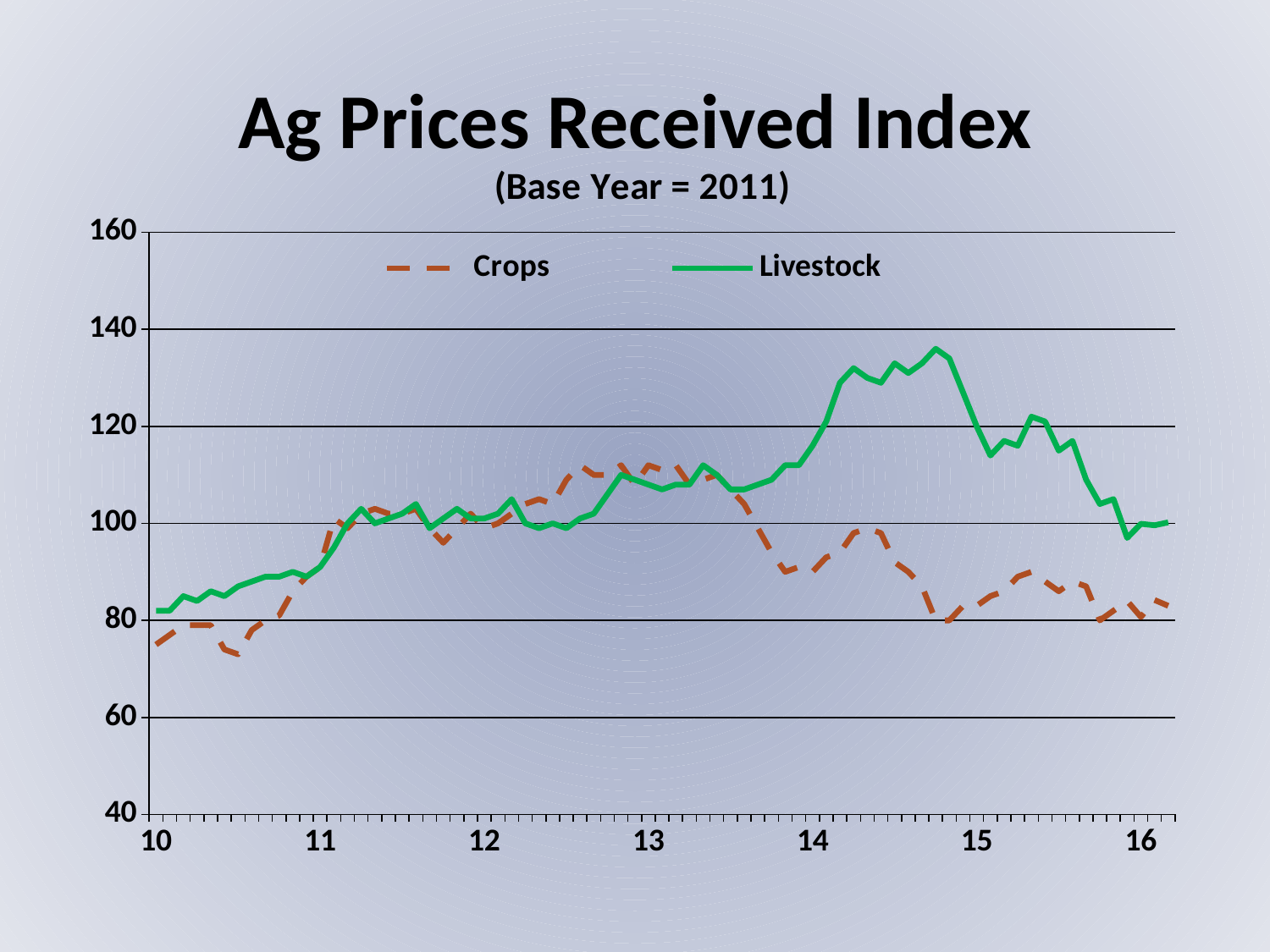
Which series reaches the highest value anywhere on the chart? Livestock Is the Crops value at the start of 2010 greater or less than 80? less Is the Crops value at the start of 2014 greater or less than 100? less Is the peak value of the Livestock line greater or less than 120? greater What is the title of the chart? Ag Prices Received Index What base year does the subtitle state for the index? 2011 At the start of 2015, which series has the higher value, Crops or Livestock? Livestock How many series does the legend list? 2 Does the Crops line rise or fall between the start of 2010 and the start of 2011? rise Does the Livestock line rise or fall between the start of 2015 and the start of 2016? fall What kind of chart is shown on the slide? line chart